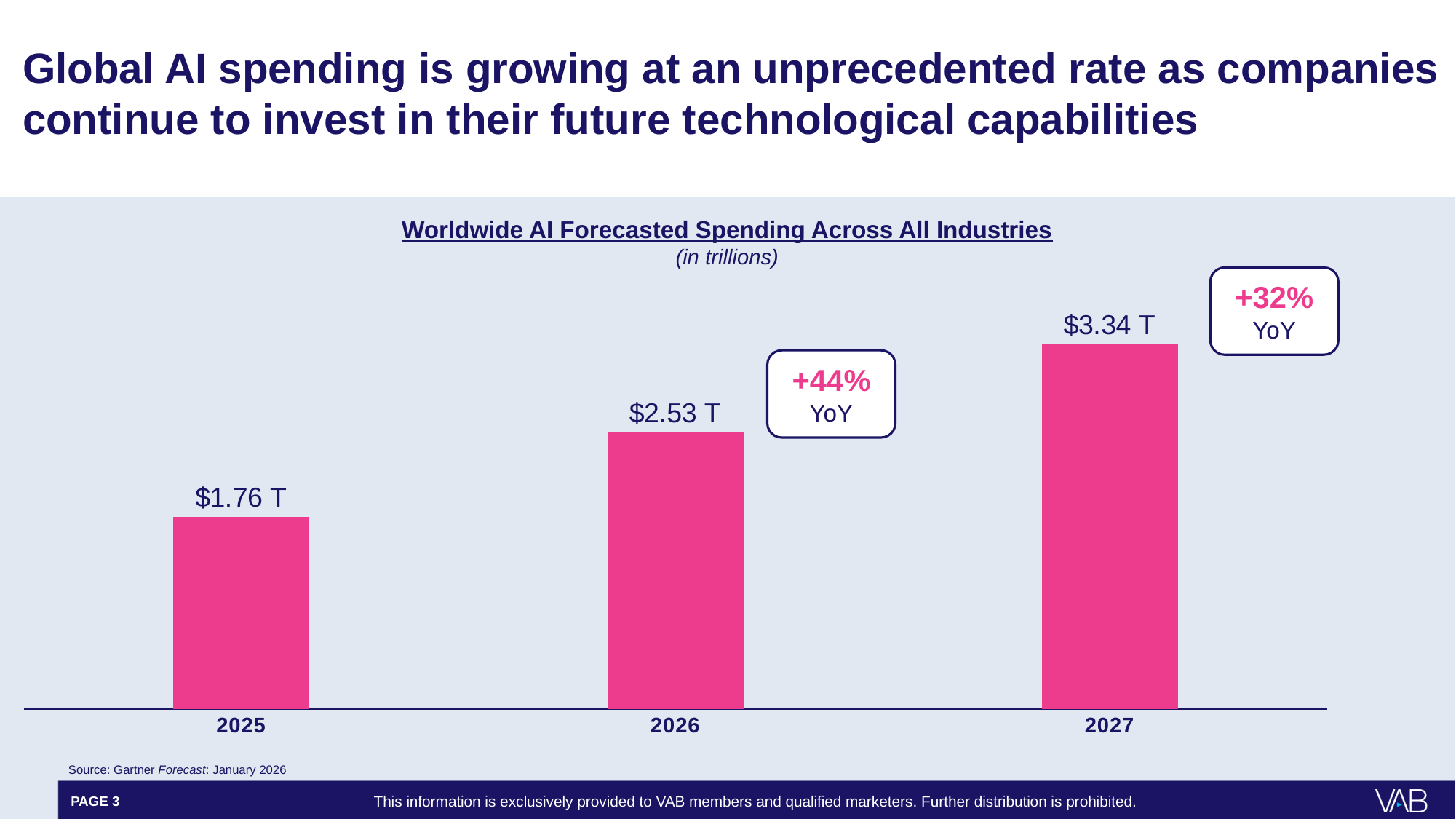
What is the difference in forecasted AI spending between 2027 and 2026? $0.81 T What is the forecasted worldwide AI spending for 2025? $1.76 T What year-over-year growth percentage is shown for 2026? +44% Which year has the highest forecasted AI spending? 2027 What is the forecasted worldwide AI spending for 2026? $2.53 T What kind of chart is shown on the slide? Bar chart What is the difference in forecasted AI spending between 2026 and 2025? $0.77 T Do the forecasted spending values rise or fall from 2025 to 2027? Rise Which year has higher forecasted AI spending, 2025 or 2026? 2026 What is the forecasted worldwide AI spending for 2027? $3.34 T How many years are shown in the chart? 3 Which year has the lowest forecasted AI spending? 2025